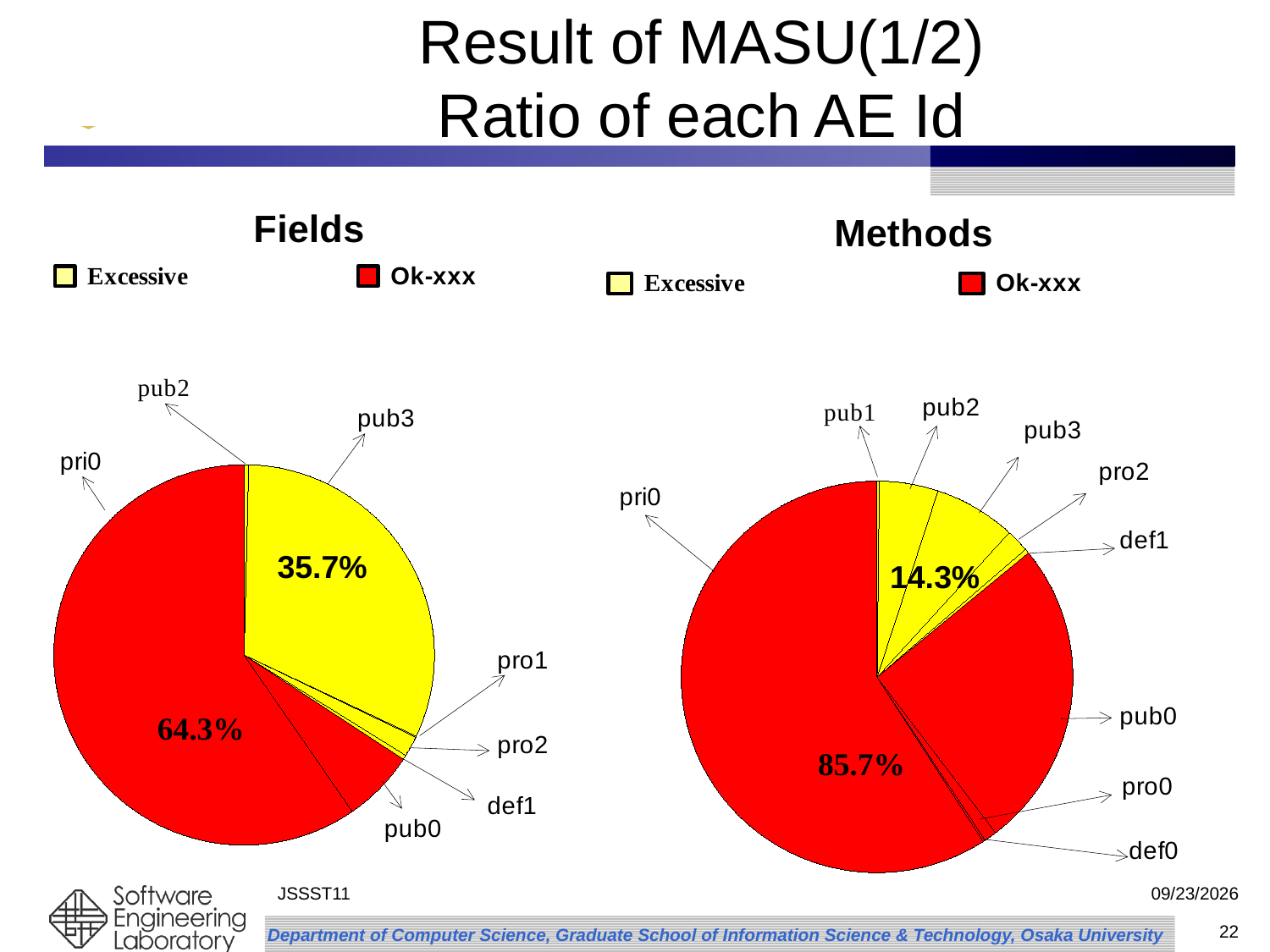
In the Methods chart, what percentage is labelled on the yellow (Excessive) portion? 14.3% In the Fields chart, which colour represents Excessive? Yellow In the Fields chart, what percentage is labelled on the red (Ok-xxx) portion? 64.3% In the Fields chart, which slice is the largest? pri0 What type of chart is used for the Fields data? Pie chart In the Methods chart, what is the difference between the Ok-xxx percentage and the Excessive percentage? 71.4% In the Methods chart, which slice is the largest? pri0 In the Fields chart, what is the difference between the Ok-xxx percentage and the Excessive percentage? 28.6% How many entries does the legend of the Methods chart list? 2 In the Methods chart, what percentage is labelled on the red (Ok-xxx) portion? 85.7% In the Fields chart, what percentage is labelled on the yellow (Excessive) portion? 35.7% Which chart has the larger Excessive share, Fields or Methods? Fields